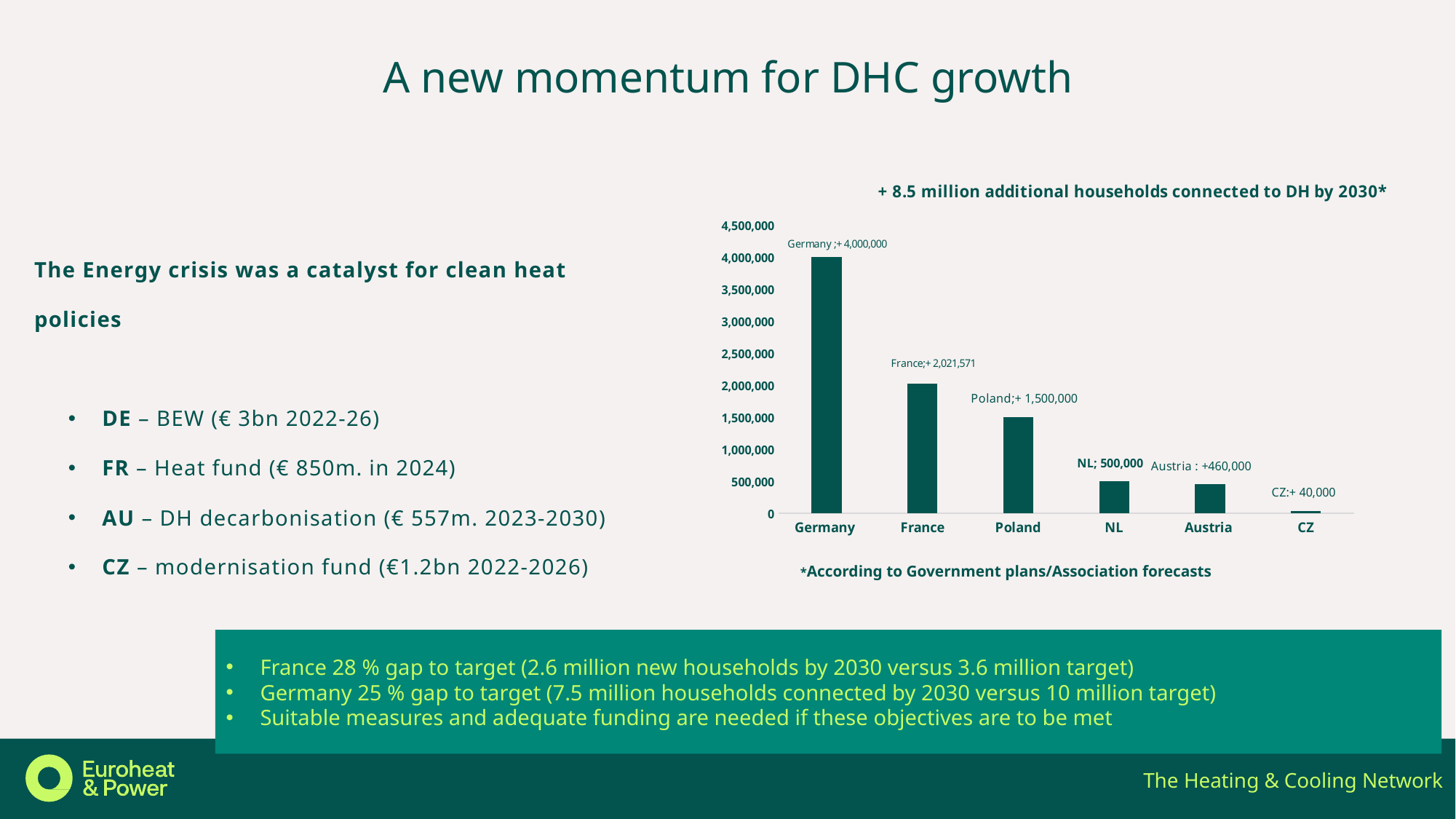
What is the value shown for Austria? 460,000 What kind of chart is shown on the slide? bar chart What is the value shown for Germany? 4,000,000 Do the values rise or fall moving from Germany to CZ along the x axis? fall How many countries are shown on the x axis of the chart? 6 What is the value shown for CZ? 40,000 Which country has the highest value in the chart? Germany What is the chart's title? + 8.5 million additional households connected to DH by 2030* What is the difference between the values for Poland and NL? 1,000,000 What is the value shown for Poland? 1,500,000 What is the value shown for France? 2,021,571 Which country has the lowest value in the chart? CZ